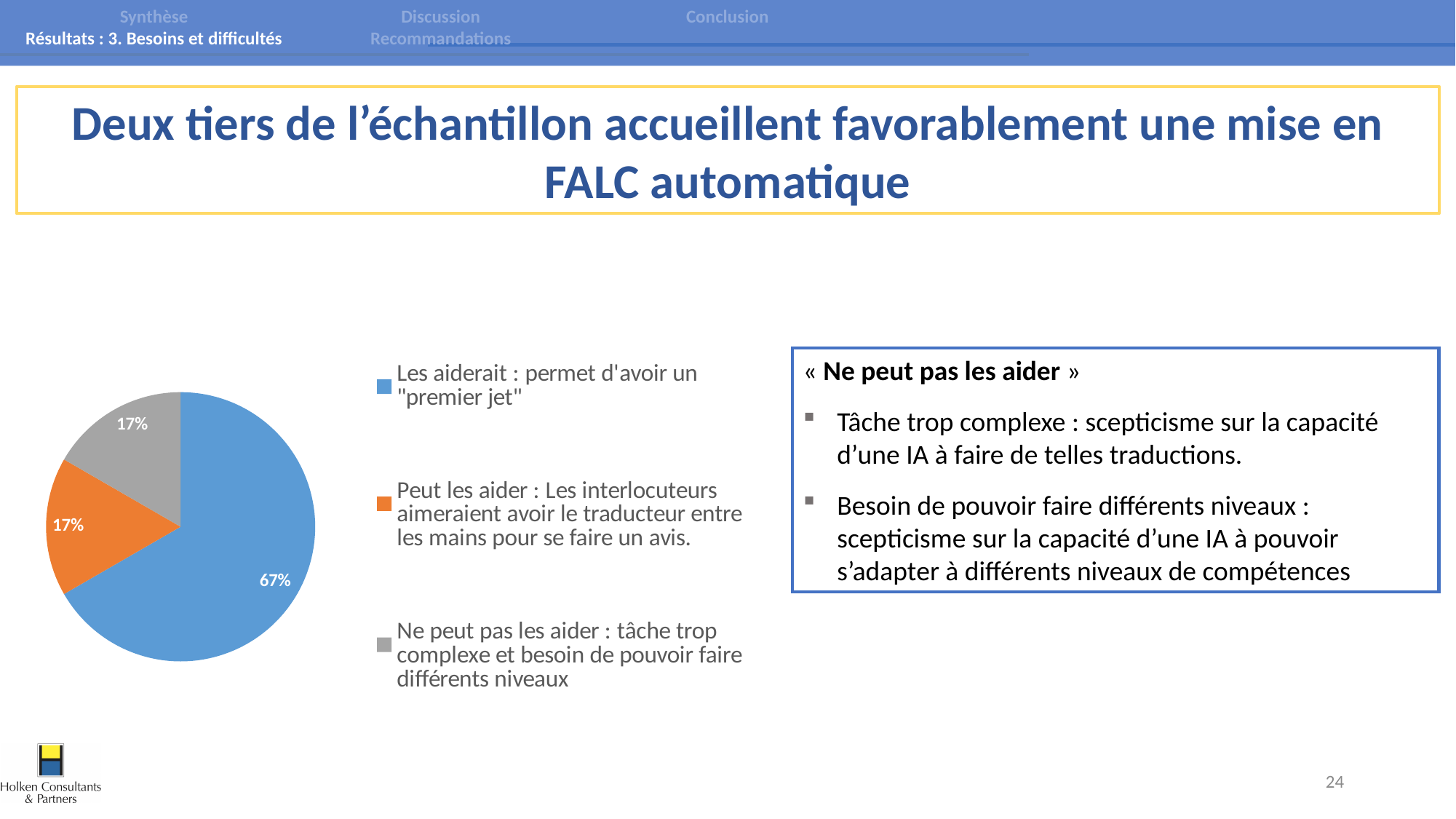
What share of the pie does the slice "Les aiderait : permet d'avoir un "premier jet"" represent? 67% What colour is the slice for "Peut les aider"? orange Is the share for "Les aiderait" greater or less than 50%? greater Which is larger: the share for "Les aiderait" or the share for "Ne peut pas les aider"? Les aiderait What is the difference between the share for "Les aiderait" and the share for "Peut les aider"? 50% How many slices does the pie chart have? 3 What share of the pie does the slice "Ne peut pas les aider" represent? 17% What colour is the slice for "Ne peut pas les aider"? grey What share of the pie does the slice "Peut les aider" represent? 17% Which category has the largest slice of the pie? Les aiderait : permet d'avoir un "premier jet" How many entries does the legend list? 3 What kind of chart is shown on the slide? pie chart